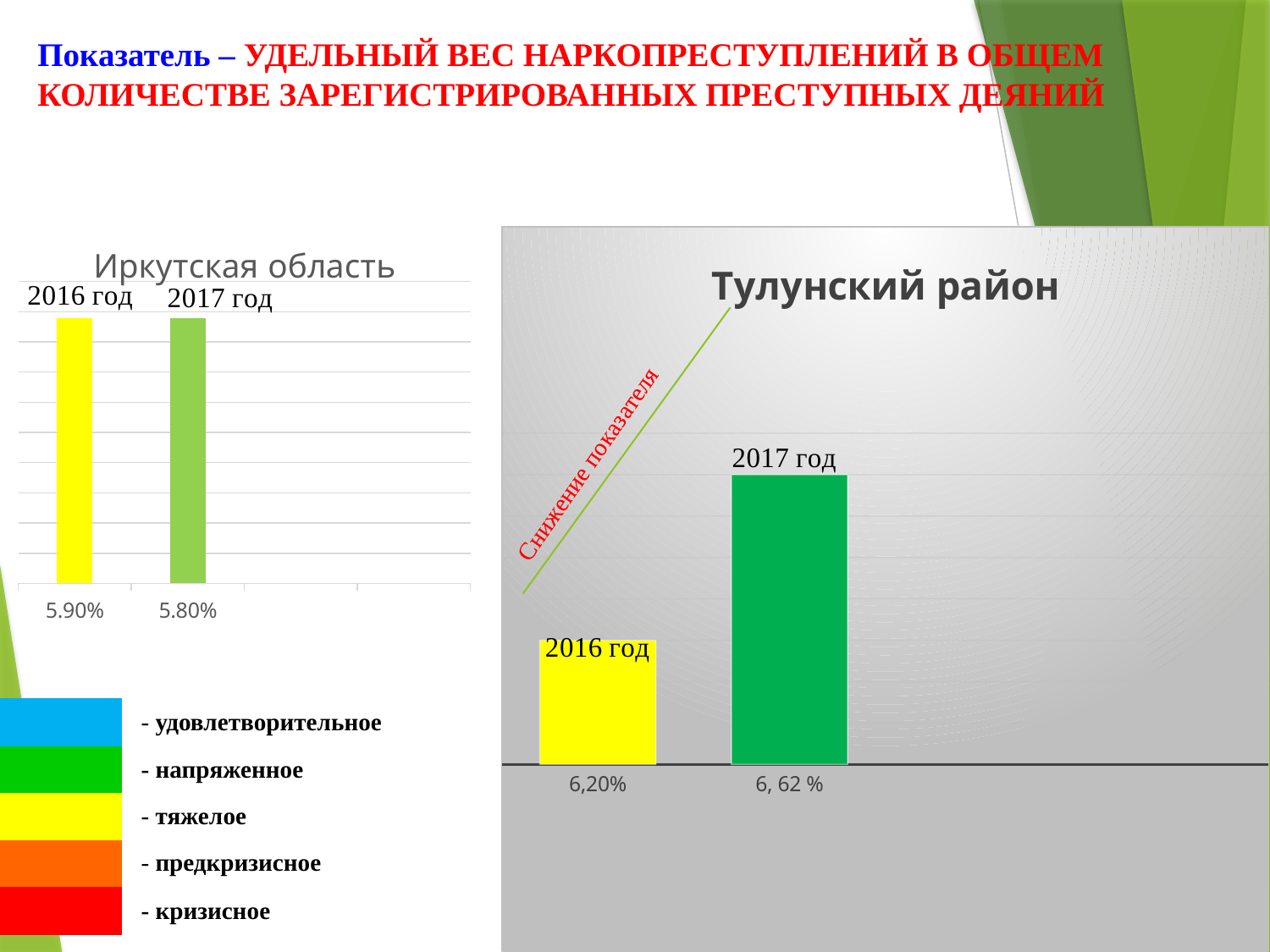
In the Иркутская область chart, what is the difference between the 2016 год and 2017 год values? 0.10% In the Тулунский район chart, what is the value for 2016 год? 6,20% In the Тулунский район chart, do the values rise or fall from 2016 год to 2017 год? rise What kind of chart is the Иркутская область chart? bar chart In the Тулунский район chart, is the value for 2016 год larger or smaller than the value for 2017 год? smaller In the Иркутская область chart, which year has the lower value? 2017 год How many bars are plotted in the Тулунский район chart? 2 In the Тулунский район chart, what is the value for 2017 год? 6, 62 % In the Иркутская область chart, what is the value for 2016 год? 5.90% In the Иркутская область chart, what is the value for 2017 год? 5.80% In the Тулунский район chart, which year has the higher value? 2017 год What is the title of the chart on the right side of the slide? Тулунский район